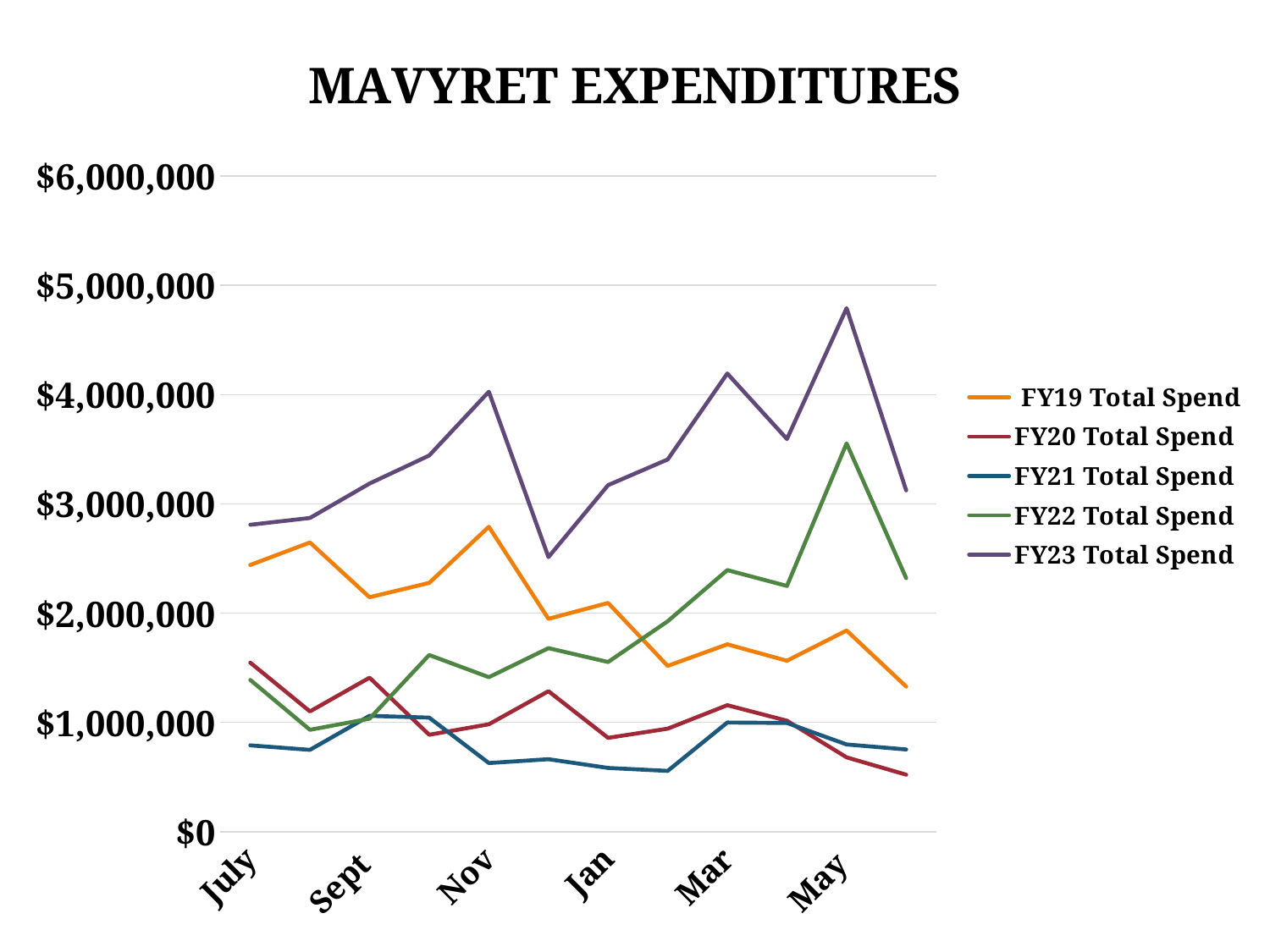
Is the value for FY23 Total Spend in May greater or less than $4,000,000? greater Which series has the highest value in May? FY23 Total Spend What kind of chart is shown on the slide? line chart How many series does the legend list? 5 Is the value for FY22 Total Spend in May greater or less than $3,000,000? greater Which series has the lowest value in Nov? FY21 Total Spend Is the value for FY19 Total Spend in July greater or less than $2,000,000? greater How many month labels are shown on the x axis? 6 In which month does FY23 Total Spend reach its highest value? May What is the title of the chart? MAVYRET EXPENDITURES In July, which is larger: FY19 Total Spend or FY21 Total Spend? FY19 Total Spend